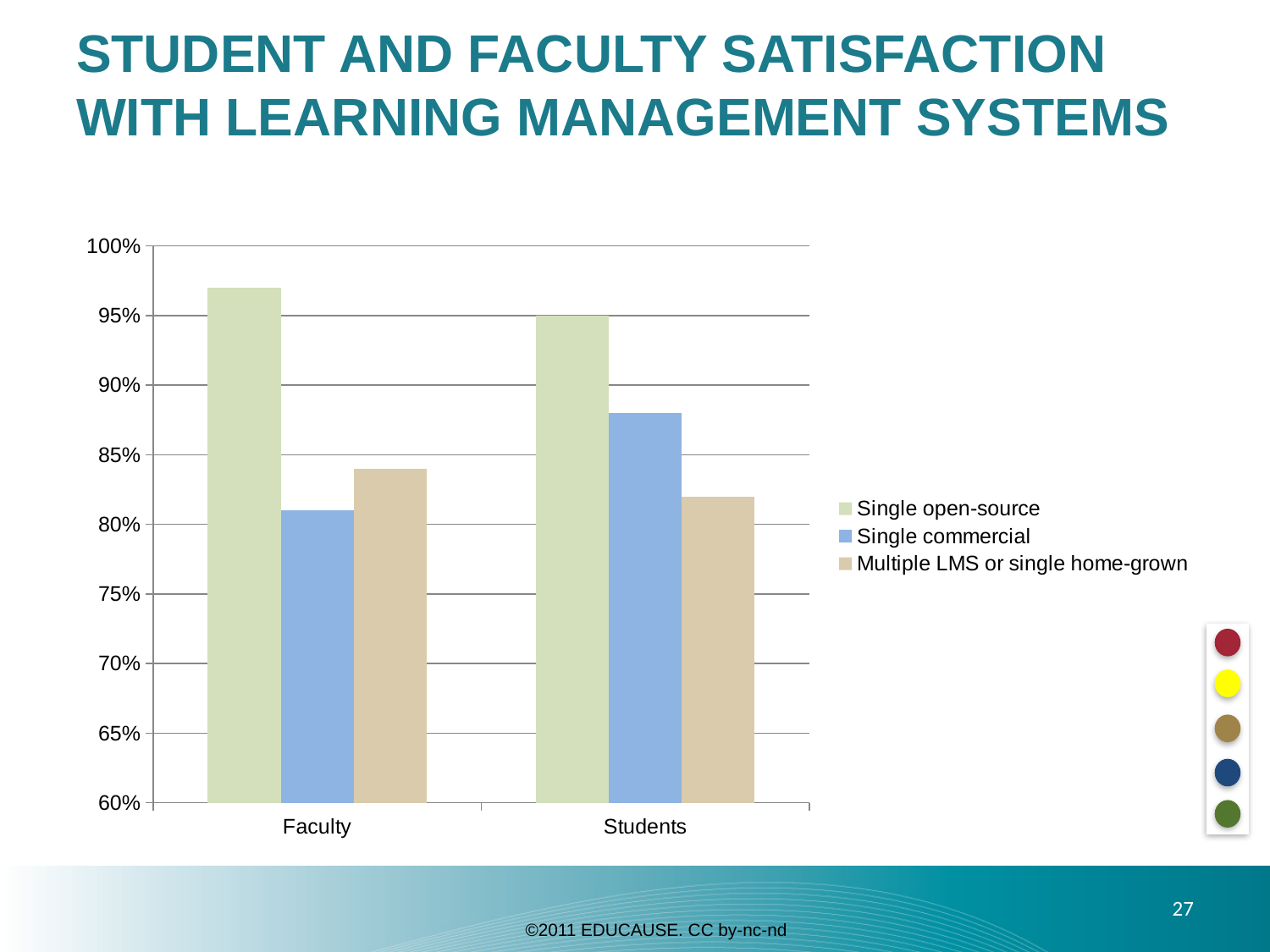
Which series has the lowest value for Faculty? Single commercial Is the value for Single commercial among Faculty greater or less than 85%? less Is the value for Single commercial among Students greater or less than 85%? greater Which series has the lowest value for Students? Multiple LMS or single home-grown Which is larger: the Multiple LMS or single home-grown value for Faculty or for Students? Faculty How many series does the legend list? 3 What is the title of the slide containing the chart? Student and Faculty Satisfaction with Learning Management Systems Which series has the highest value for Faculty? Single open-source Is the value for Single open-source among Faculty greater or less than 95%? greater How many categories are shown on the x axis? 2 Which is larger: the Single commercial value for Faculty or for Students? Students What kind of chart is shown on the slide? bar chart